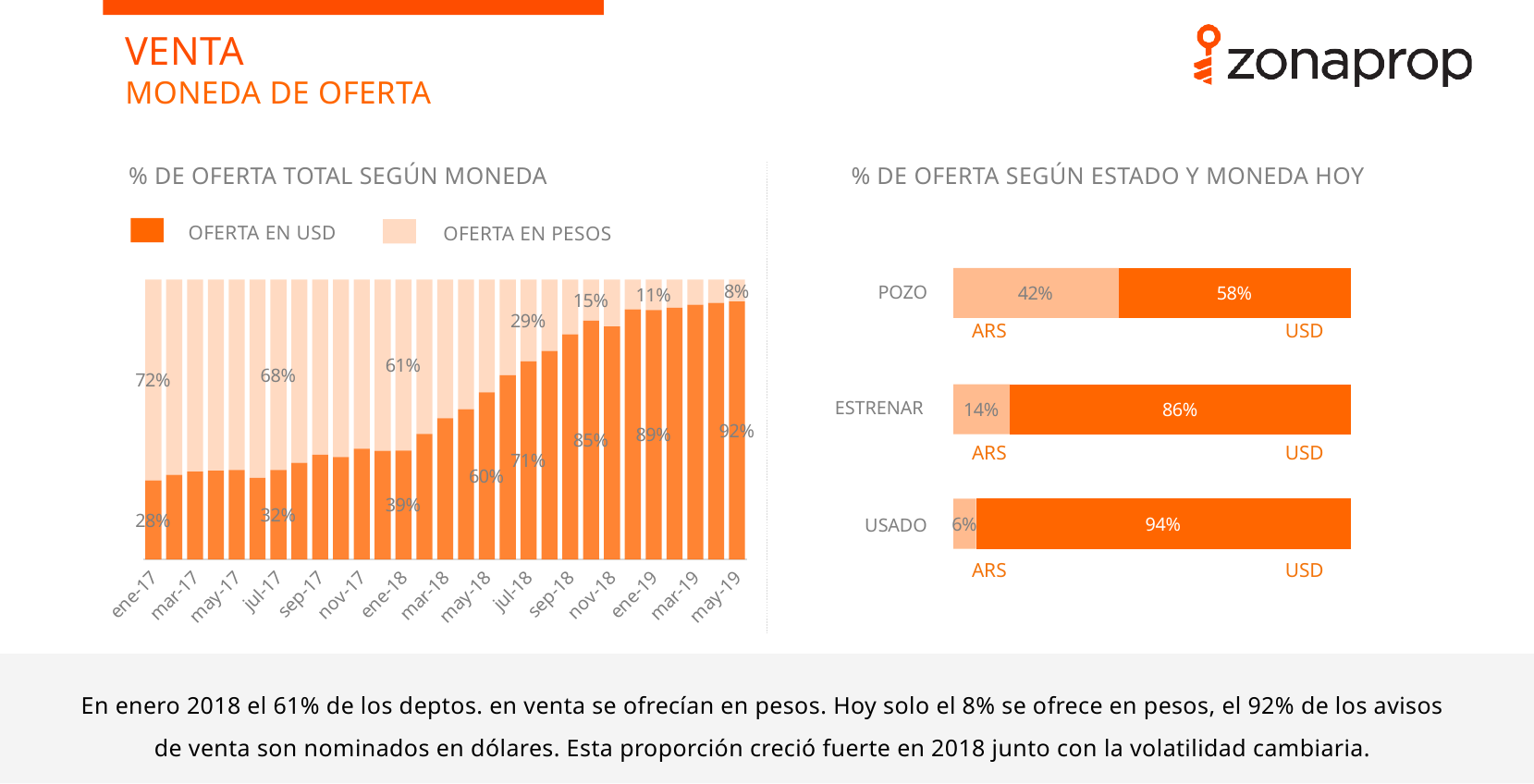
In the chart '% DE OFERTA TOTAL SEGÚN MONEDA', what is the OFERTA EN USD value for ene-17? 28% In the chart '% DE OFERTA TOTAL SEGÚN MONEDA', what is the OFERTA EN PESOS value for ene-18? 61% In the chart '% DE OFERTA SEGÚN ESTADO Y MONEDA HOY', which category has the highest USD share? USADO In the chart '% DE OFERTA SEGÚN ESTADO Y MONEDA HOY', what is the difference between the USD share of ESTRENAR and the USD share of POZO? 28% In the chart '% DE OFERTA SEGÚN ESTADO Y MONEDA HOY', which category has the lowest USD share? POZO In the chart '% DE OFERTA TOTAL SEGÚN MONEDA', what is the OFERTA EN USD value for may-19? 92% In the chart '% DE OFERTA SEGÚN ESTADO Y MONEDA HOY', what is the ARS share for POZO? 42% What kind of chart is '% DE OFERTA SEGÚN ESTADO Y MONEDA HOY'? stacked bar chart In the chart '% DE OFERTA TOTAL SEGÚN MONEDA', does the OFERTA EN USD share rise or fall from ene-17 to may-19? rise In the chart '% DE OFERTA SEGÚN ESTADO Y MONEDA HOY', what is the USD share for USADO? 94% In the chart '% DE OFERTA SEGÚN ESTADO Y MONEDA HOY', how many categories are shown? 3 In the chart '% DE OFERTA TOTAL SEGÚN MONEDA', how many series does the legend list? 2